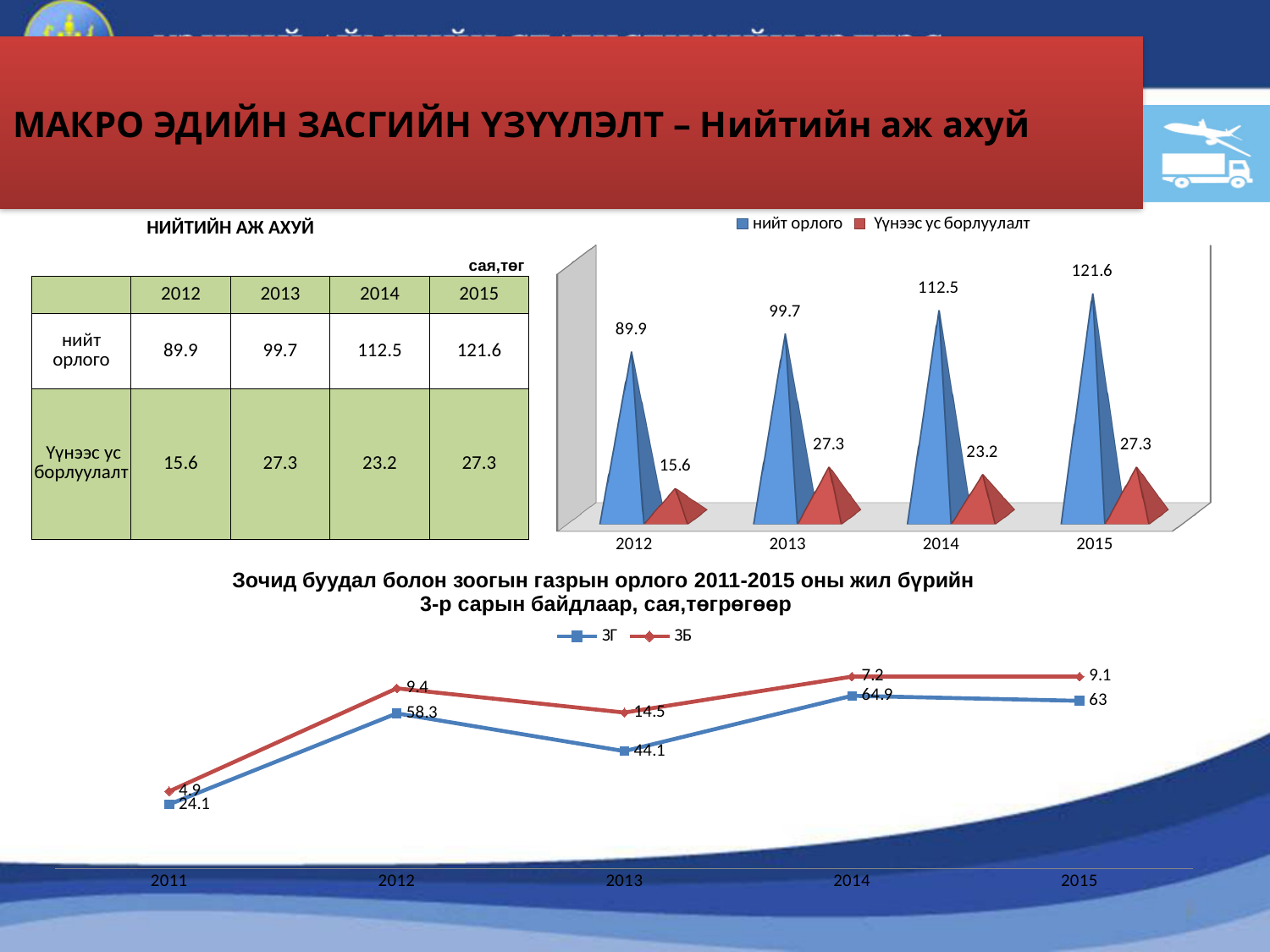
In the chart titled 'Зочид буудал болон зоогын газрын орлого 2011-2015', what is the value of ЗГ for 2013? 44.1 In the top-right chart, what is the value of нийт орлого for 2014? 112.5 What kind of chart is the one titled 'Зочид буудал болон зоогын газрын орлого 2011-2015'? line chart In the top-right chart, what is the difference between нийт орлого in 2015 and in 2012? 31.7 How many years are shown on the x axis of the chart titled 'Зочид буудал болон зоогын газрын орлого 2011-2015'? 5 In the top-right chart, which year has the highest нийт орлого? 2015 How many series does the legend of the top-right chart list? 2 In the top-right chart, which year has the lowest Үүнээс ус борлуулалт? 2012 In the top-right chart, what is the value of Үүнээс ус борлуулалт for 2012? 15.6 In the top-right chart, does нийт орлого rise or fall from 2012 to 2015? rise In the chart titled 'Зочид буудал болон зоогын газрын орлого 2011-2015', which year has the highest ЗГ value? 2014 In the chart titled 'Зочид буудал болон зоогын газрын орлого 2011-2015', what is the value of ЗБ for 2015? 9.1